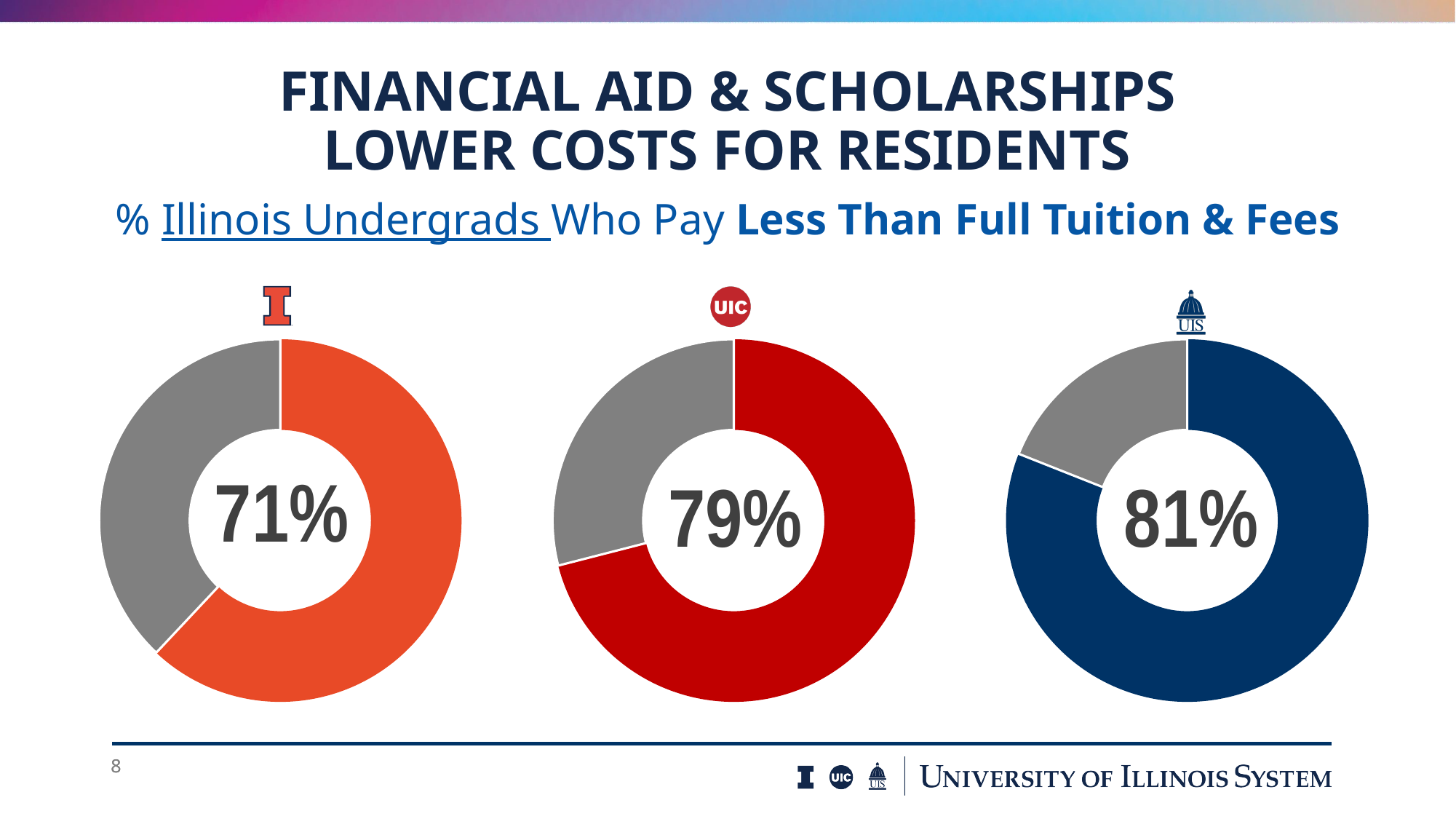
What percentage is shown in the centre of the left donut chart? 71% In the left donut chart, what share of the ring is the grey segment? 29% What percentage is shown in the centre of the middle donut chart (UIC)? 79% What colour is the main (non-grey) segment of the middle donut chart (UIC)? Red What is the difference between the percentage in the right donut chart (UIS) and the left donut chart? 10 percentage points Which of the three donut charts shows the lowest percentage? The left chart, 71% Which of the three donut charts shows the highest percentage? The right chart (UIS), 81% Is the percentage in the middle donut chart (UIC) larger or smaller than the percentage in the right donut chart (UIS)? Smaller How many donut charts are on the slide? 3 What percentage is shown in the centre of the right donut chart (UIS)? 81% What is the difference between the percentage in the middle donut chart (UIC) and the left donut chart? 8 percentage points What kind of charts are shown on the slide? Donut (pie) charts